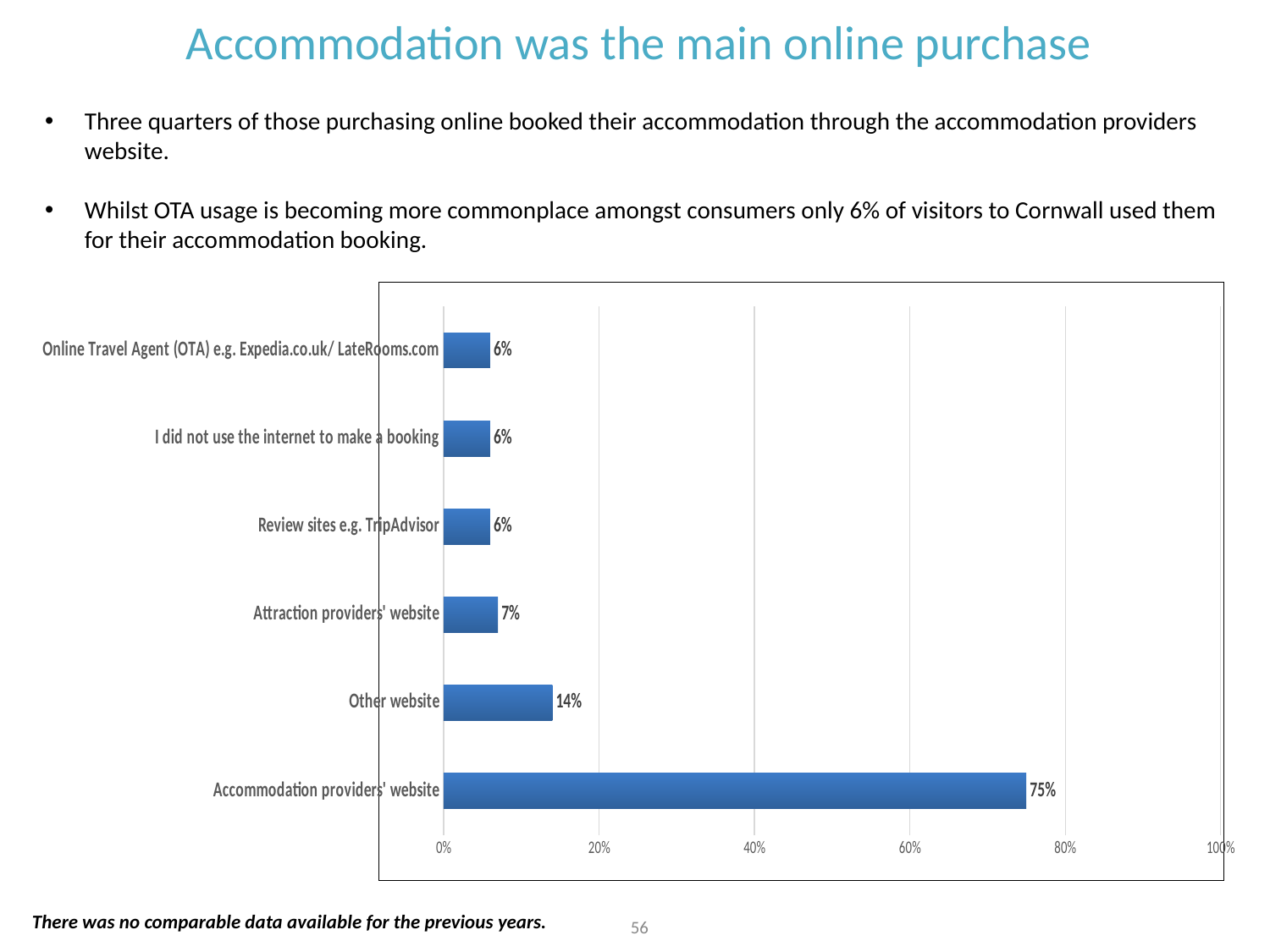
What is the value for Review sites e.g. TripAdvisor? 6% Which is larger, Other website or Attraction providers' website? Other website What is the difference between Other website and Attraction providers' website? 7% What is the difference between Accommodation providers' website and Other website? 61% How many categories are shown in the chart? 6 What is the value for Other website? 14% Is the value for Accommodation providers' website greater or less than 60%? greater What is the value for Attraction providers' website? 7% Which category has the highest value? Accommodation providers' website What is the value for Online Travel Agent (OTA) e.g. Expedia.co.uk/ LateRooms.com? 6% What kind of chart is shown on the slide? bar chart What is the value for Accommodation providers' website? 75%